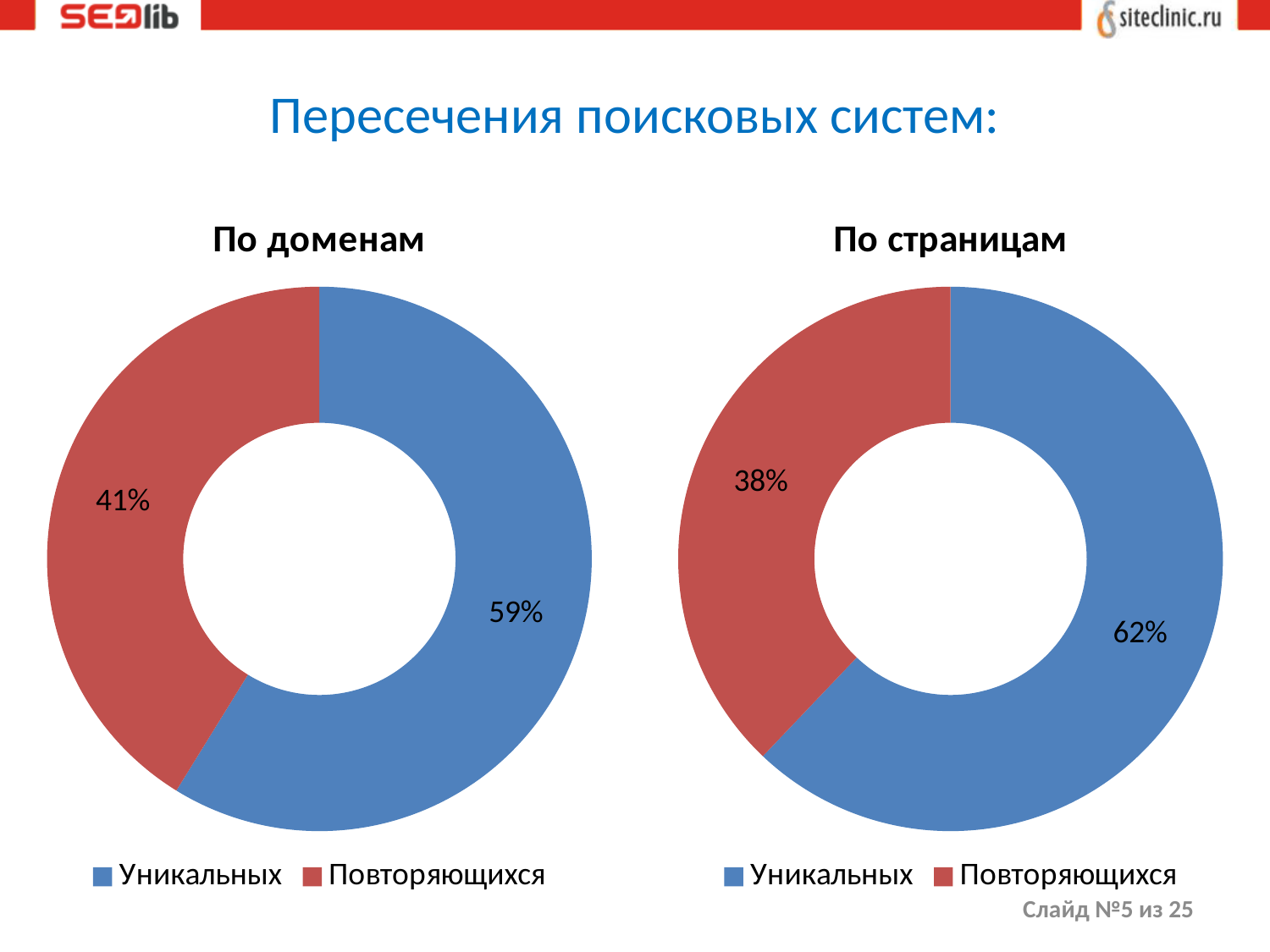
In the "По страницам" chart, what is the value for Повторяющихся? 38% In the "По доменам" chart, which category has the largest share? Уникальных Which is larger: Повторяющихся in the "По доменам" chart or Повторяющихся in the "По страницам" chart? По доменам What is the title of the chart on the left? По доменам In the "По доменам" chart, what is the value for Уникальных? 59% In the "По доменам" chart, what is the difference between Уникальных and Повторяющихся? 18% In the "По страницам" chart, what is the value for Уникальных? 62% In the "По страницам" chart, which category has the smallest share? Повторяющихся In the "По страницам" chart, what is the difference between Уникальных and Повторяющихся? 24% In the "По доменам" chart, what is the value for Повторяющихся? 41% How many categories does the legend of the "По доменам" chart list? 2 What kind of chart is the "По страницам" chart? Doughnut chart